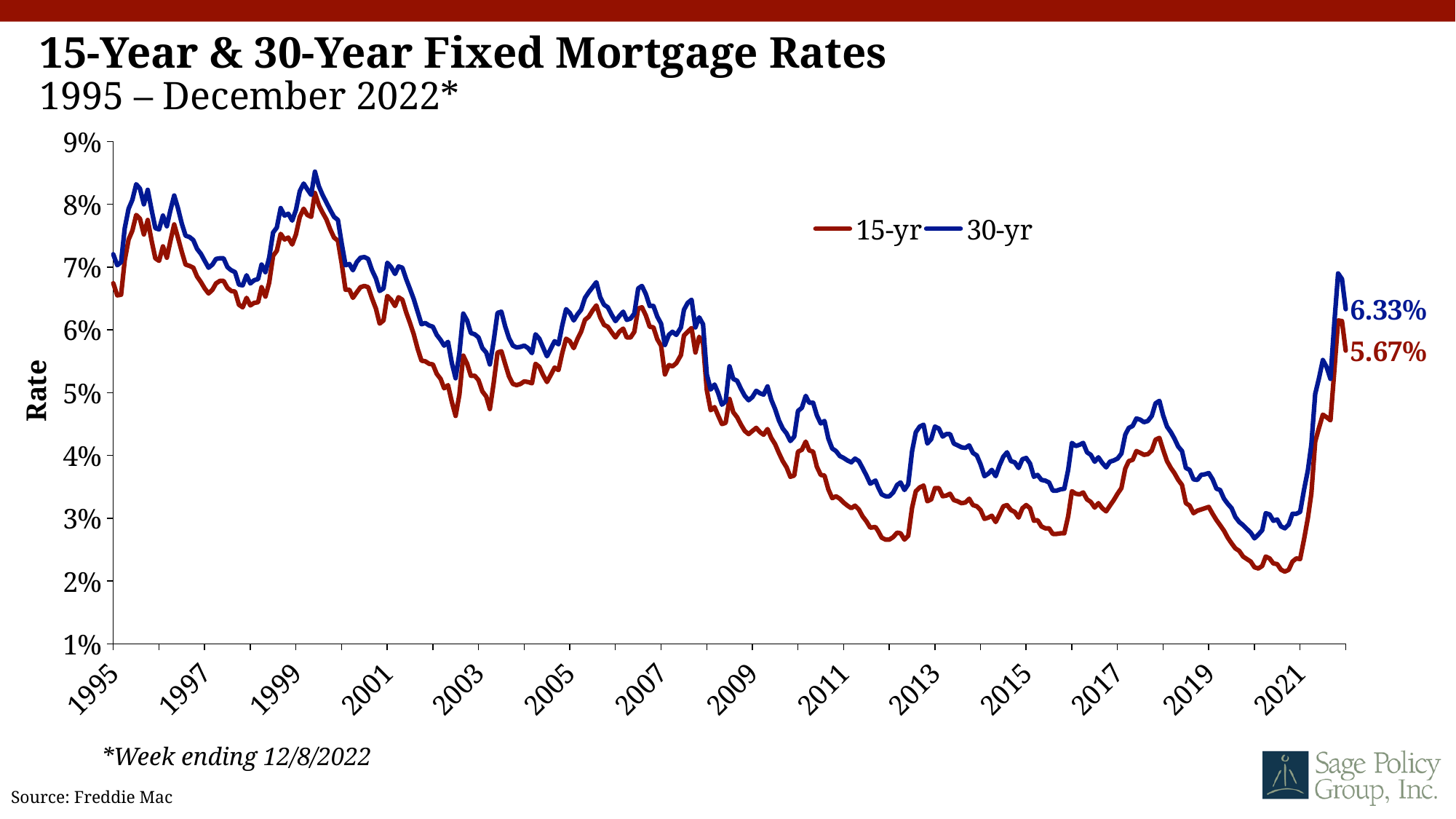
At the end of the chart, which series has the higher rate, 15-yr or 30-yr? 30-yr What kind of chart is shown on the slide? Line chart How many series does the legend list? 2 Is the 15-yr rate at the 2021 tick greater or less than 3%? less Is the 15-yr rate at the 2013 tick greater or less than 4%? less What is the difference between the latest 30-yr value (6.33%) and the latest 15-yr value (5.67%)? 0.66 percentage points What is the title of the chart? 15-Year & 30-Year Fixed Mortgage Rates From 1995 to 2021, did the 30-yr rate generally rise or fall? Fall Which colour is used for the 30-yr series? Blue What is the latest value shown for the 30-yr series? 6.33% What is the latest value shown for the 15-yr series? 5.67% Is the 30-yr rate at the start of 1995 greater or less than 6%? greater